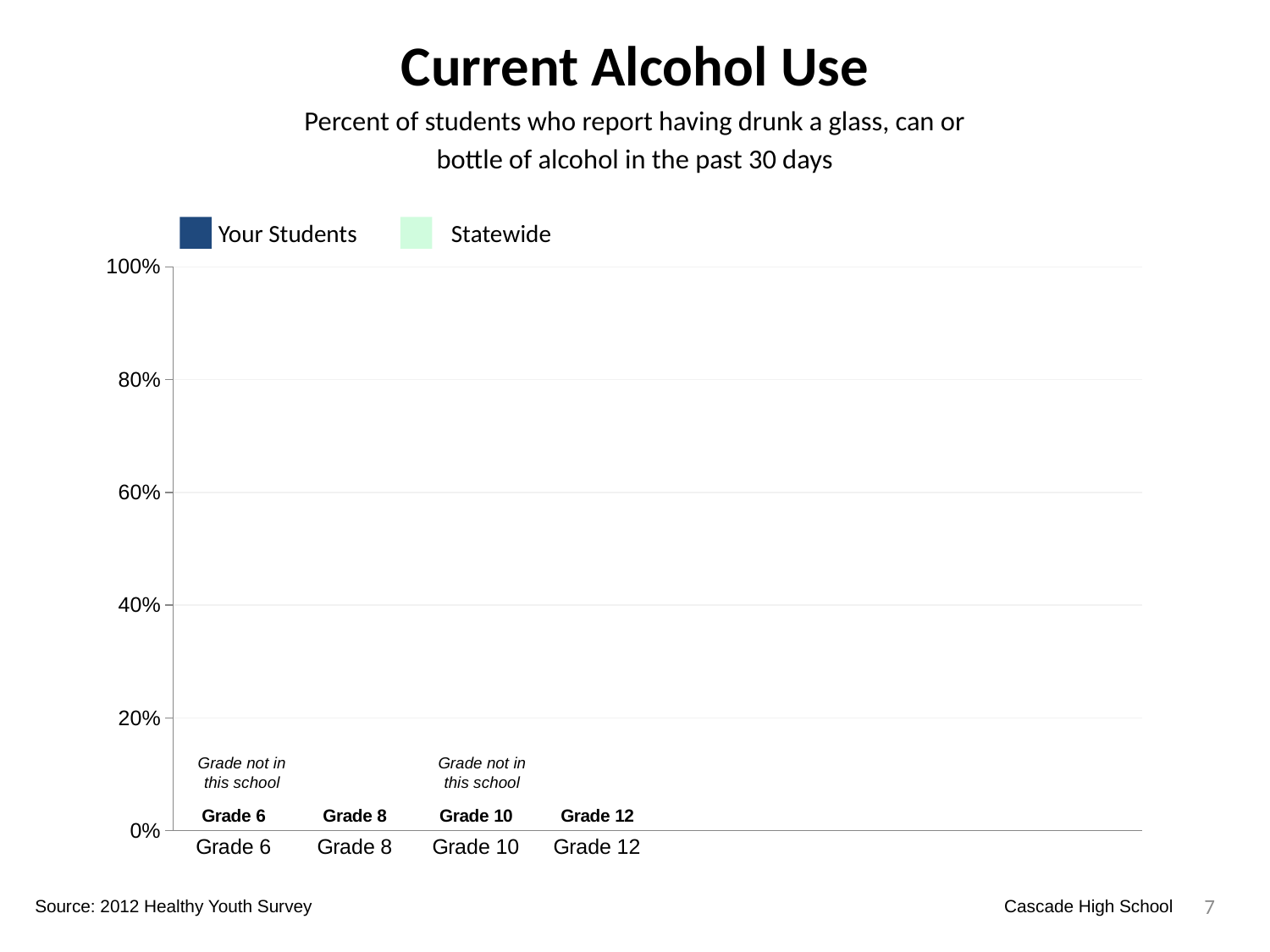
What is the highest value shown on the chart's y axis? 100% What is the title of the chart on the slide? Current Alcohol Use Which grade categories are marked as 'Grade not in this school' on the chart? Grade 6 and Grade 10 How many series does the chart's legend list? 2 What are the two series named in the chart's legend? Your Students and Statewide How many grade categories are shown on the x axis of the chart? 4